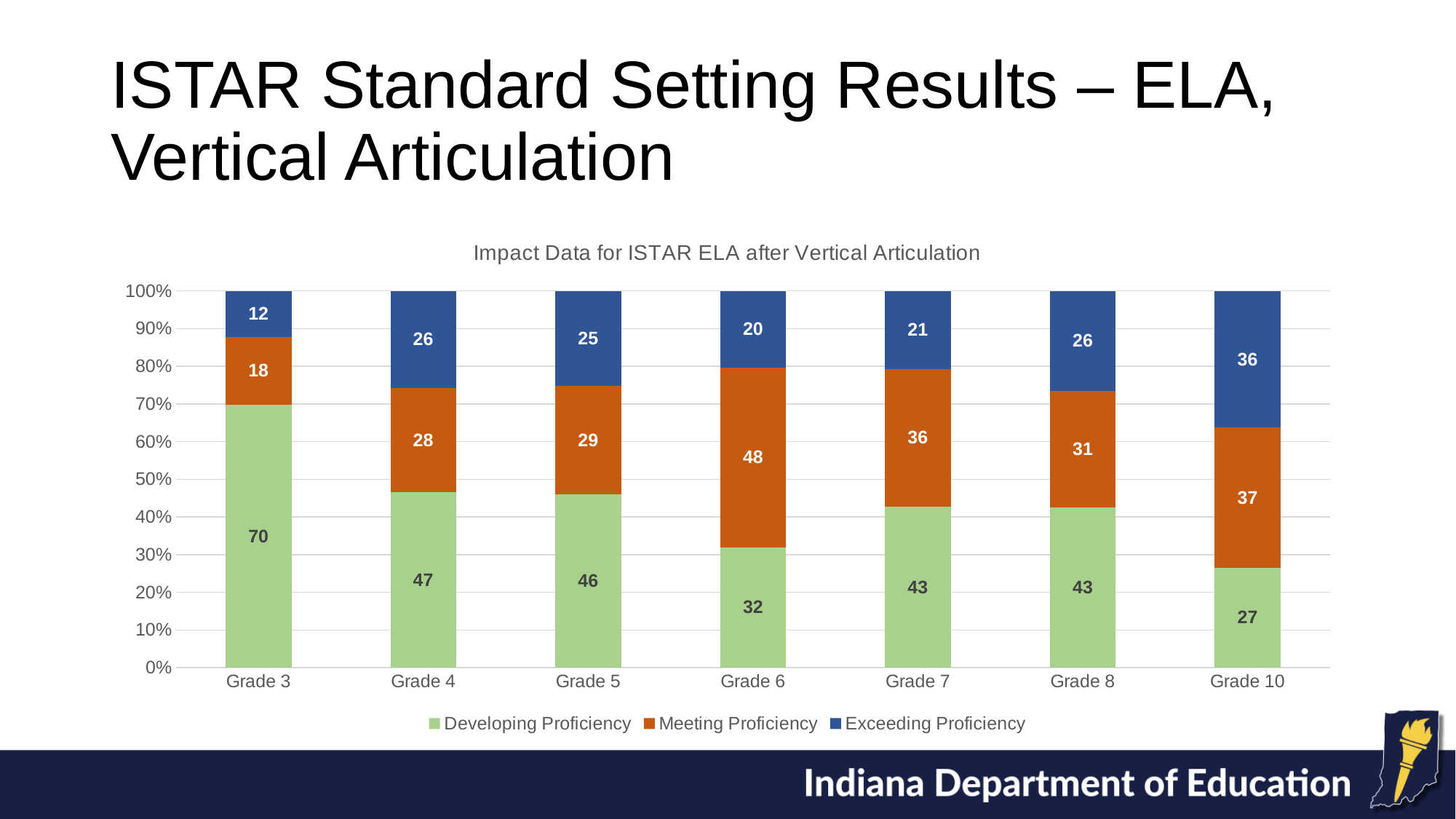
Which is larger, the Developing Proficiency value for Grade 4 or for Grade 10? Grade 4 What kind of chart is shown on the slide? Stacked bar chart How many grades are shown on the x axis? 7 How many series does the legend list? 3 What is the Developing Proficiency value for Grade 3? 70 What is the Exceeding Proficiency value for Grade 10? 36 Which grade has the highest Developing Proficiency value? Grade 3 Which grade has the lowest Exceeding Proficiency value? Grade 3 What is the Meeting Proficiency value for Grade 6? 48 What is the difference between the Meeting Proficiency values for Grade 6 and Grade 3? 30 Which colour represents Exceeding Proficiency in the chart? Blue What is the title of the chart? Impact Data for ISTAR ELA after Vertical Articulation